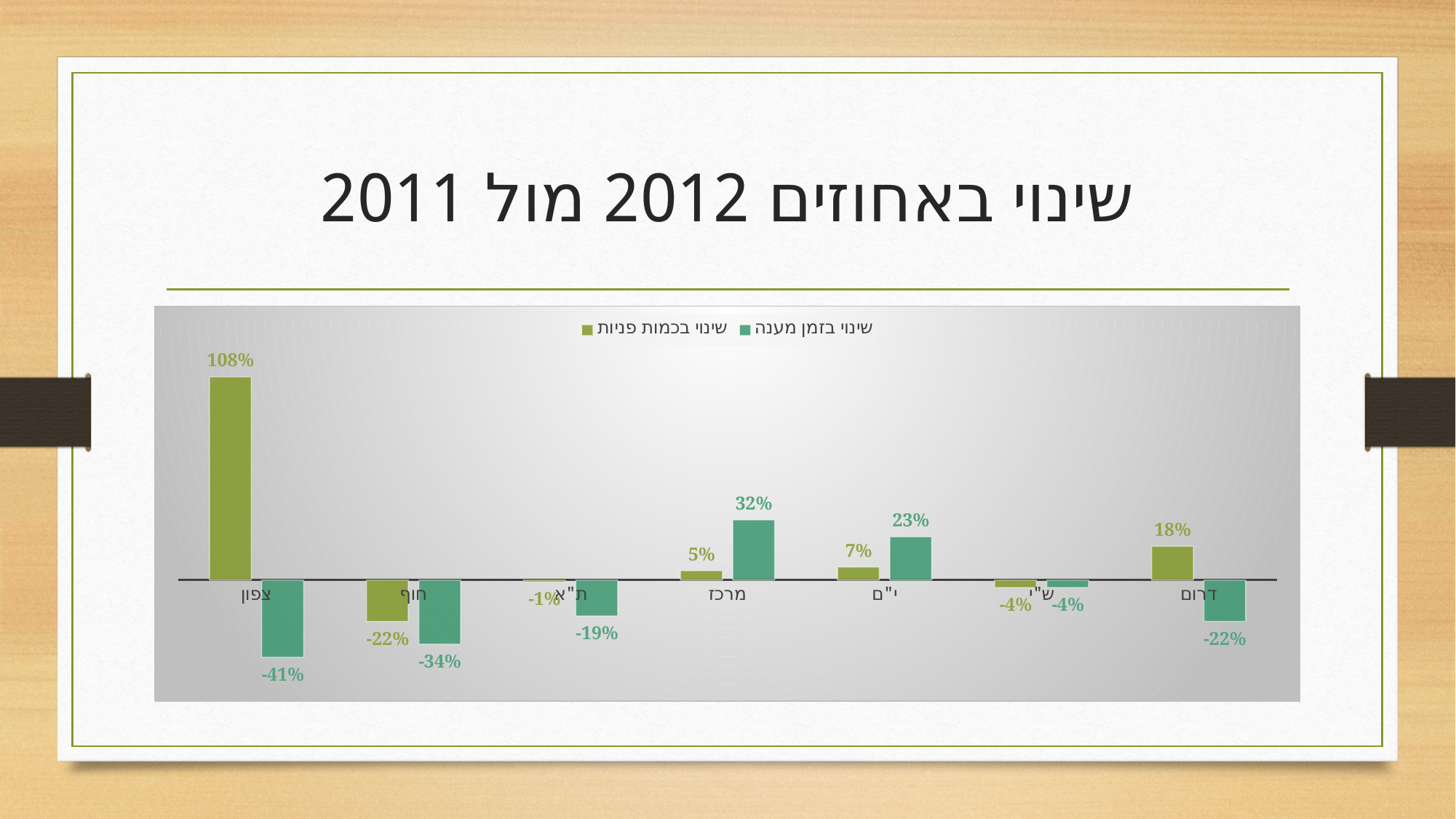
Which category has the lowest value for שינוי בזמן מענה? צפון What kind of chart is shown on the slide? bar chart What is the value of שינוי בכמות פניות for צפון? 108% How many categories are shown on the x axis? 7 What is the value of שינוי בזמן מענה for מרכז? 32% What is the difference between the שינוי בזמן מענה values for מרכז and י"ם? 9% What is the value of שינוי בכמות פניות for דרום? 18% What is the title of the slide? שינוי באחוזים 2012 מול 2011 What is the value of שינוי בזמן מענה for חוף? -34% Which is larger: שינוי בכמות פניות for י"ם or for מרכז? י"ם Which category has the highest value for שינוי בכמות פניות? צפון How many series does the legend list? 2